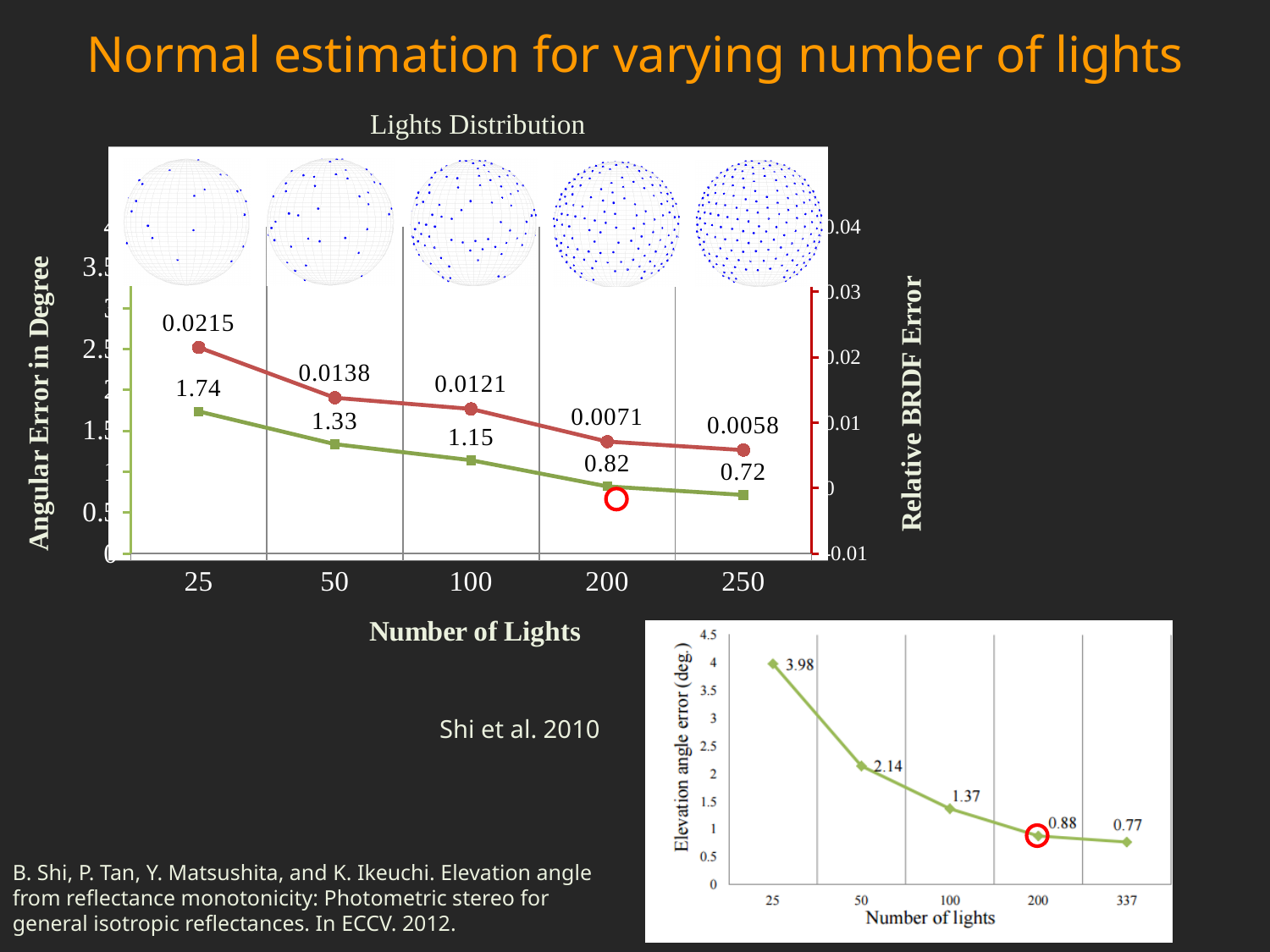
In the main chart, what is the angular error in degrees for 200 lights? 0.82 In the main chart, how many number-of-lights categories are plotted on the x axis? 5 In the main chart, which number of lights has the highest angular error? 25 In the inset chart at the bottom right, what is the elevation angle error for 337 lights? 0.77 In the main chart, what is the difference in angular error between 25 lights and 50 lights? 0.41 In the inset chart at the bottom right, what is the elevation angle error for 50 lights? 2.14 In the main chart, what is the relative BRDF error for 100 lights? 0.0121 In the inset chart at the bottom right, is the elevation angle error for 25 lights greater or less than 2.14 for 50 lights? greater In the main chart, which number of lights has the lowest relative BRDF error? 250 In the main chart, what type of chart is used to show the errors? Line chart In the main chart, what is the angular error in degrees for 25 lights? 1.74 In the main chart, how does the angular error change as the number of lights increases? It decreases